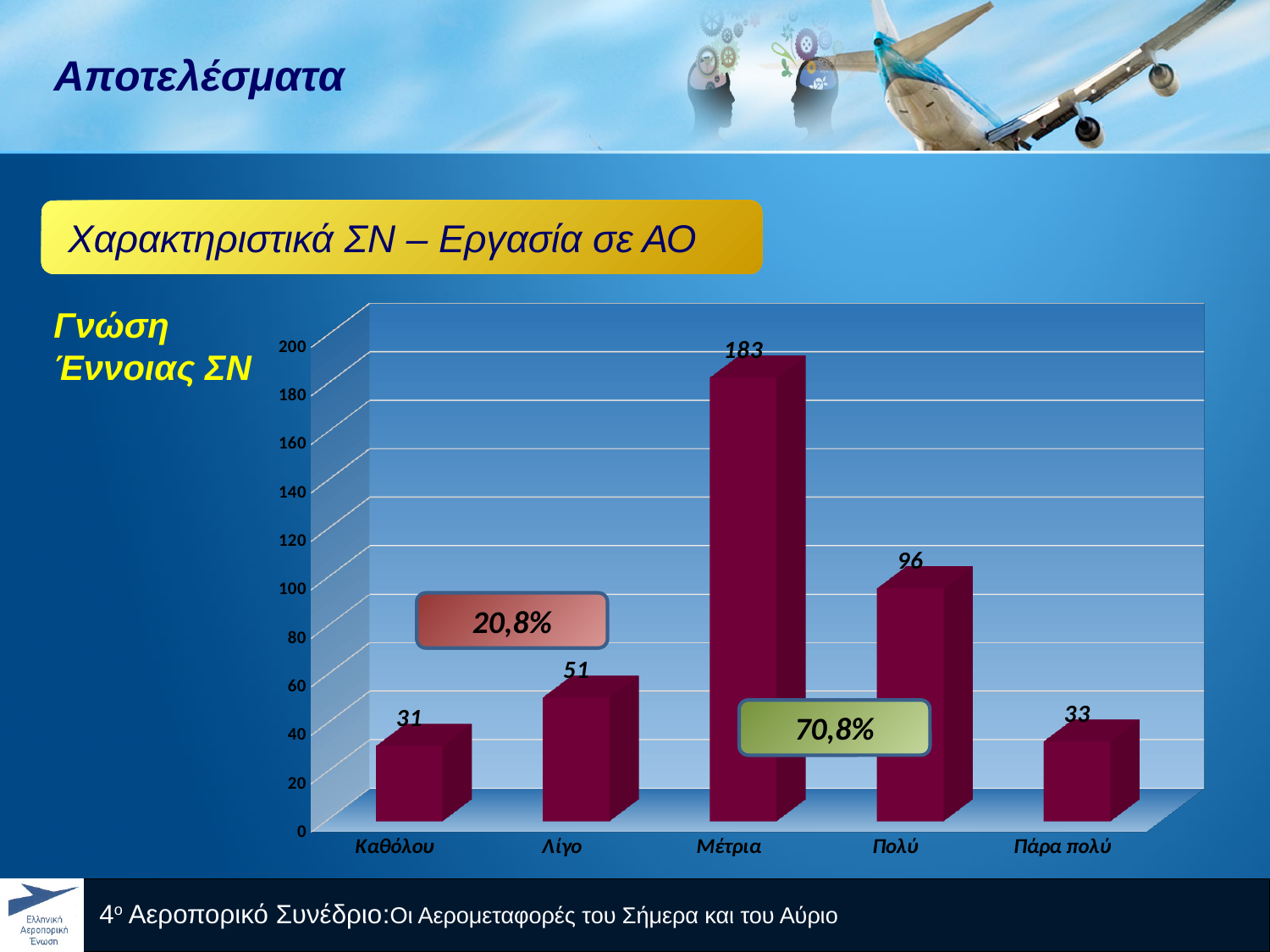
Which category has the lowest value? Καθόλου What kind of chart is shown on the slide? bar chart Which is larger, the value for Λίγο or the value for Πάρα πολύ? Λίγο Is the value for Πολύ greater or less than 100? less What percentage is shown in the red callout box over the Καθόλου and Λίγο bars? 20,8% What percentage is shown in the green callout box over the Μέτρια and Πολύ bars? 70,8% How many categories are shown on the x axis? 5 Which category has the highest value? Μέτρια What is the value for Πάρα πολύ? 33 What is the value for Μέτρια? 183 What is the value for Καθόλου? 31 What is the difference between the values for Μέτρια and Πολύ? 87